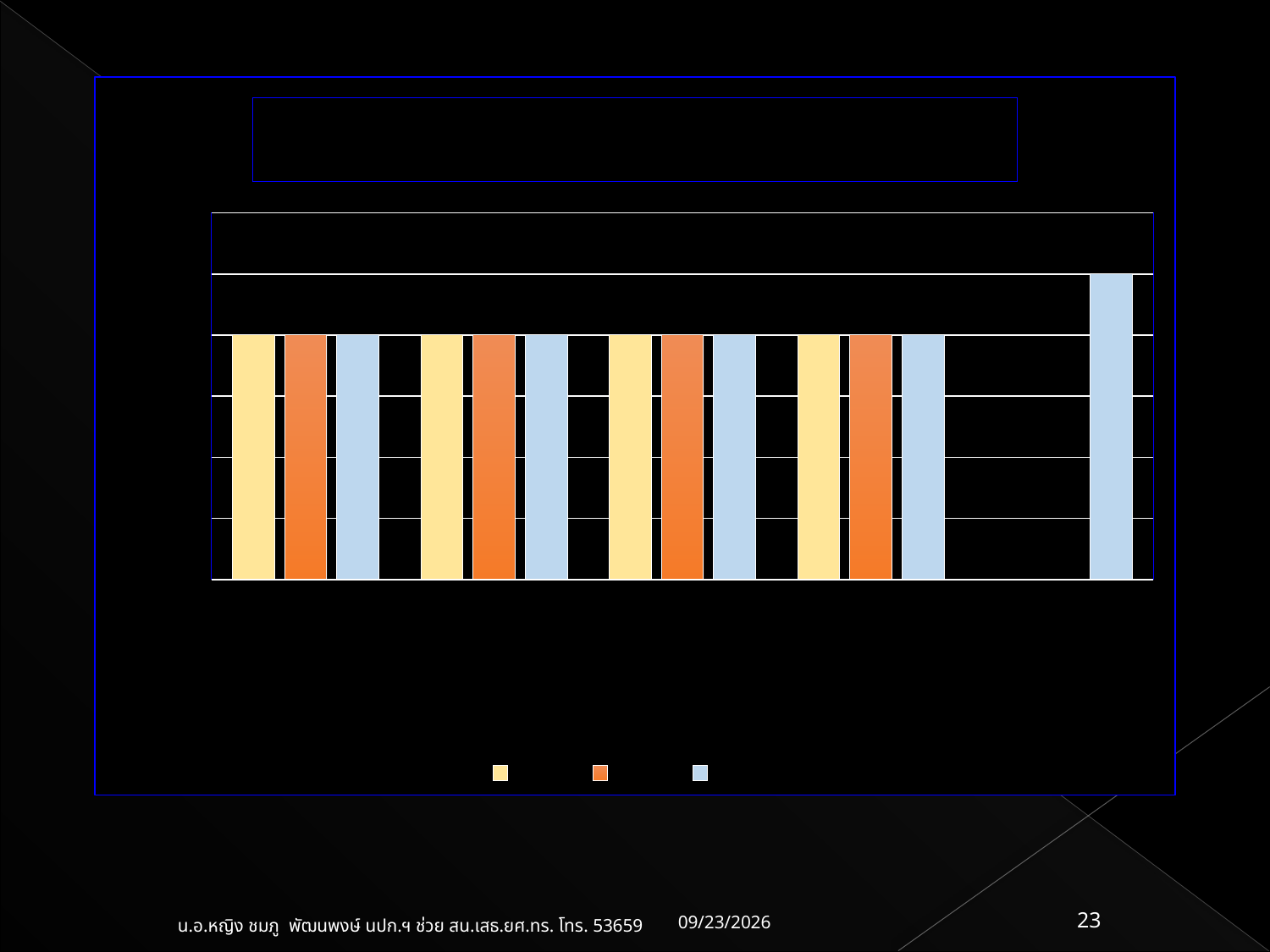
What kind of chart is shown on the slide? bar chart What colour is the tallest bar on the chart? light blue How many bars are in the rightmost group? 1 How many series does the legend list? 3 How many groups of bars are plotted along the x axis? 5 Which group of bars, counting from the left, contains the tallest bar? the fifth (rightmost) group What are the three colours of the series shown in the legend, from left to right? yellow, orange, light blue